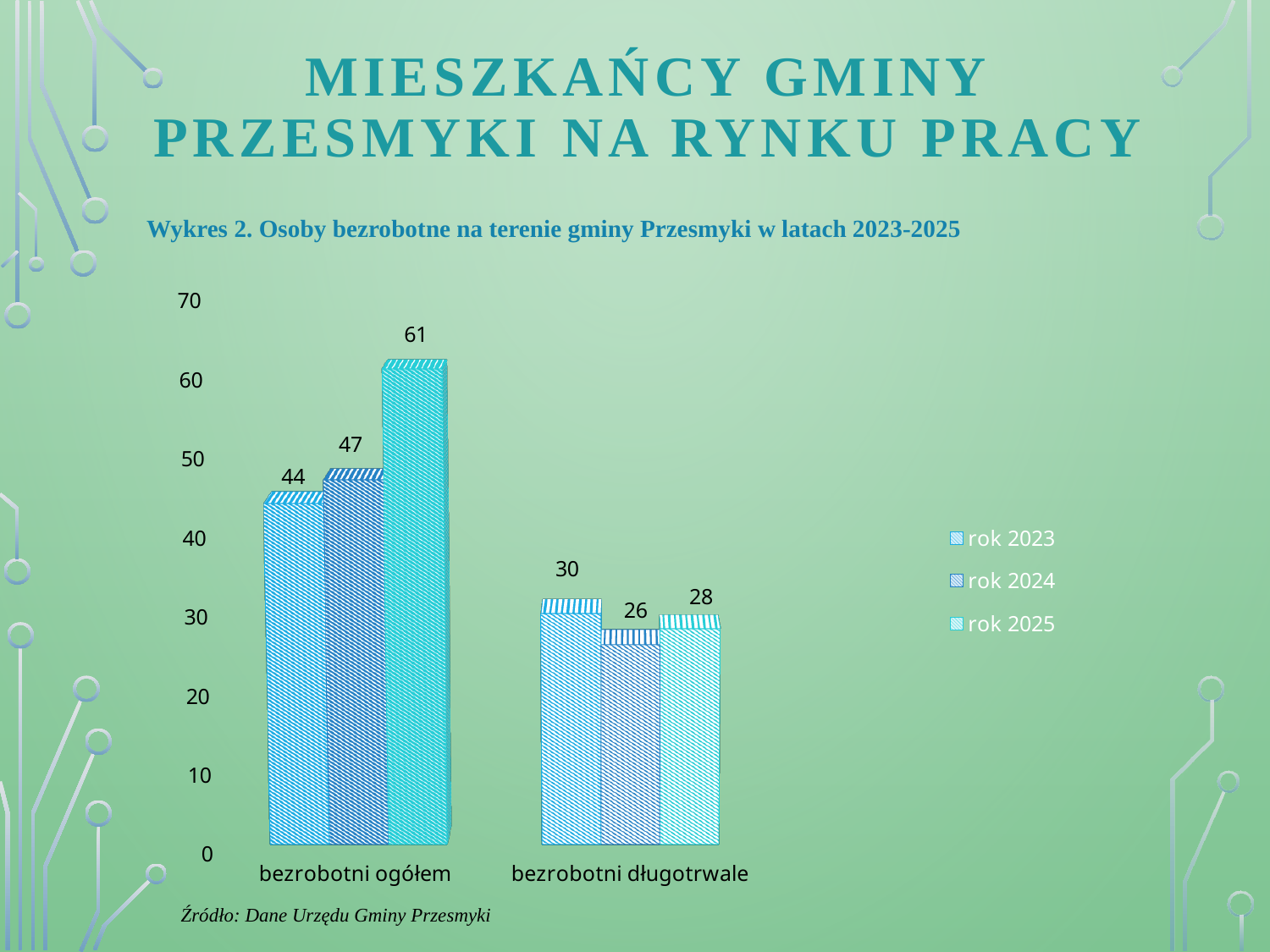
Which is larger: the 'rok 2023' value for 'bezrobotni długotrwale' or the 'rok 2025' value for 'bezrobotni długotrwale'? rok 2023 What kind of chart is shown on the slide? bar chart Which year has the highest value for 'bezrobotni ogółem'? rok 2025 What is the difference between the 'rok 2025' and 'rok 2023' values for 'bezrobotni ogółem'? 17 How many categories are shown on the x axis? 2 What is the value for 'bezrobotni długotrwale' in the 'rok 2023' series? 30 What is the value for 'bezrobotni długotrwale' in the 'rok 2025' series? 28 Which year has the lowest value for 'bezrobotni długotrwale'? rok 2024 How many series does the legend list? 3 What is the title of the chart? Wykres 2. Osoby bezrobotne na terenie gminy Przesmyki w latach 2023-2025 What is the value for 'bezrobotni ogółem' in the 'rok 2025' series? 61 What is the value for 'bezrobotni ogółem' in the 'rok 2024' series? 47